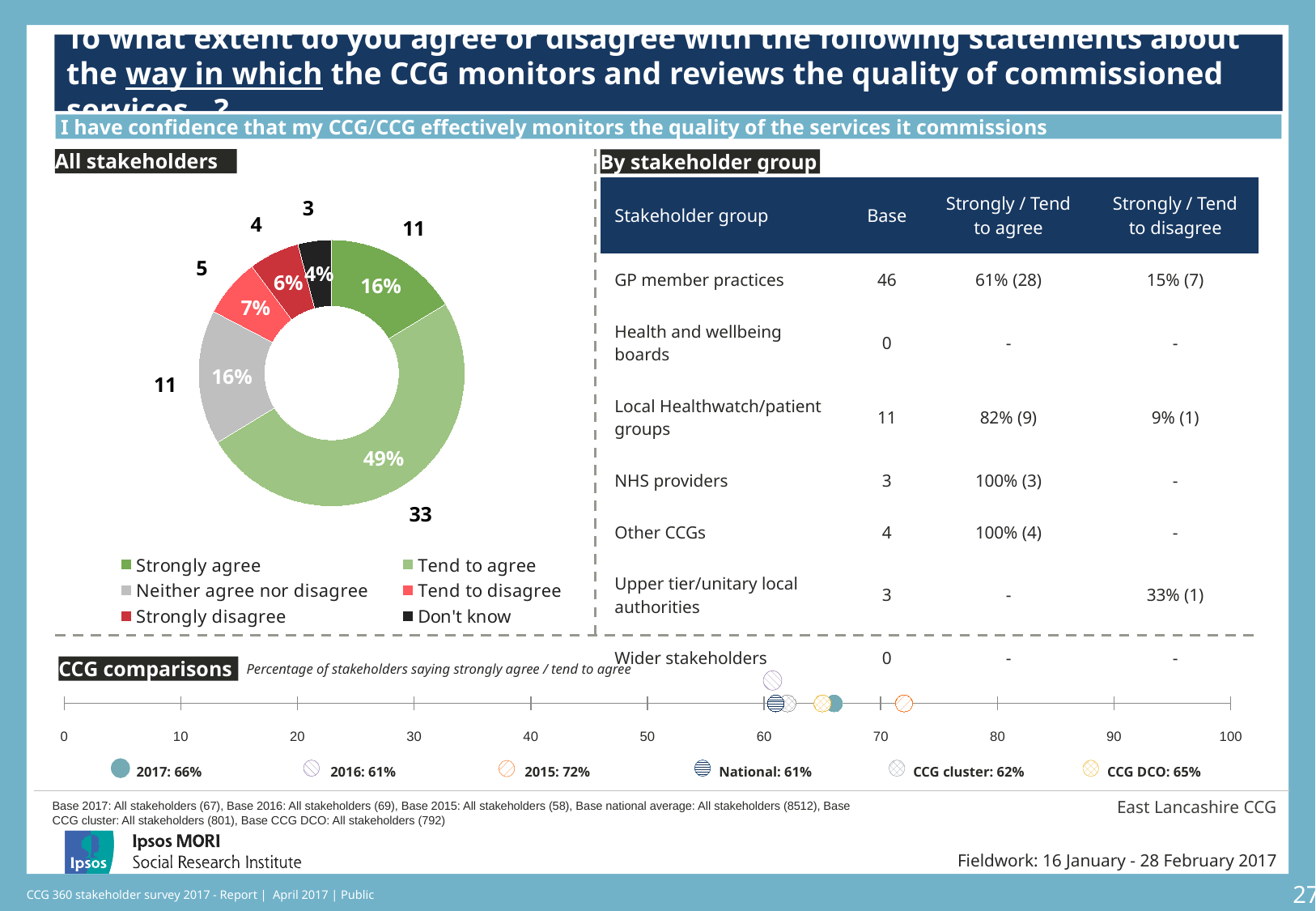
In the All stakeholders donut chart, what is the difference in percentage points between 'Tend to agree' and 'Strongly agree'? 33 percentage points In the All stakeholders donut chart, how many stakeholders said 'Tend to agree'? 33 In the All stakeholders donut chart, what percentage of stakeholders said 'Tend to agree'? 49% In the All stakeholders donut chart, what percentage of stakeholders said 'Strongly agree'? 16% In the All stakeholders donut chart, what is the combined percentage of 'Strongly agree' and 'Tend to agree'? 65% In the CCG comparisons chart, what is the 2017 percentage of stakeholders saying strongly agree / tend to agree? 66% In the All stakeholders donut chart, which is larger: 'Tend to disagree' or 'Strongly disagree'? Tend to disagree In the All stakeholders donut chart, how many response categories are shown in the legend? 6 In the CCG comparisons chart, which comparison point has the highest value? 2015: 72% In the All stakeholders donut chart, which response has the smallest share? Don't know What type of chart is used for the All stakeholders section? Donut (pie) chart In the All stakeholders donut chart, which response has the largest share? Tend to agree